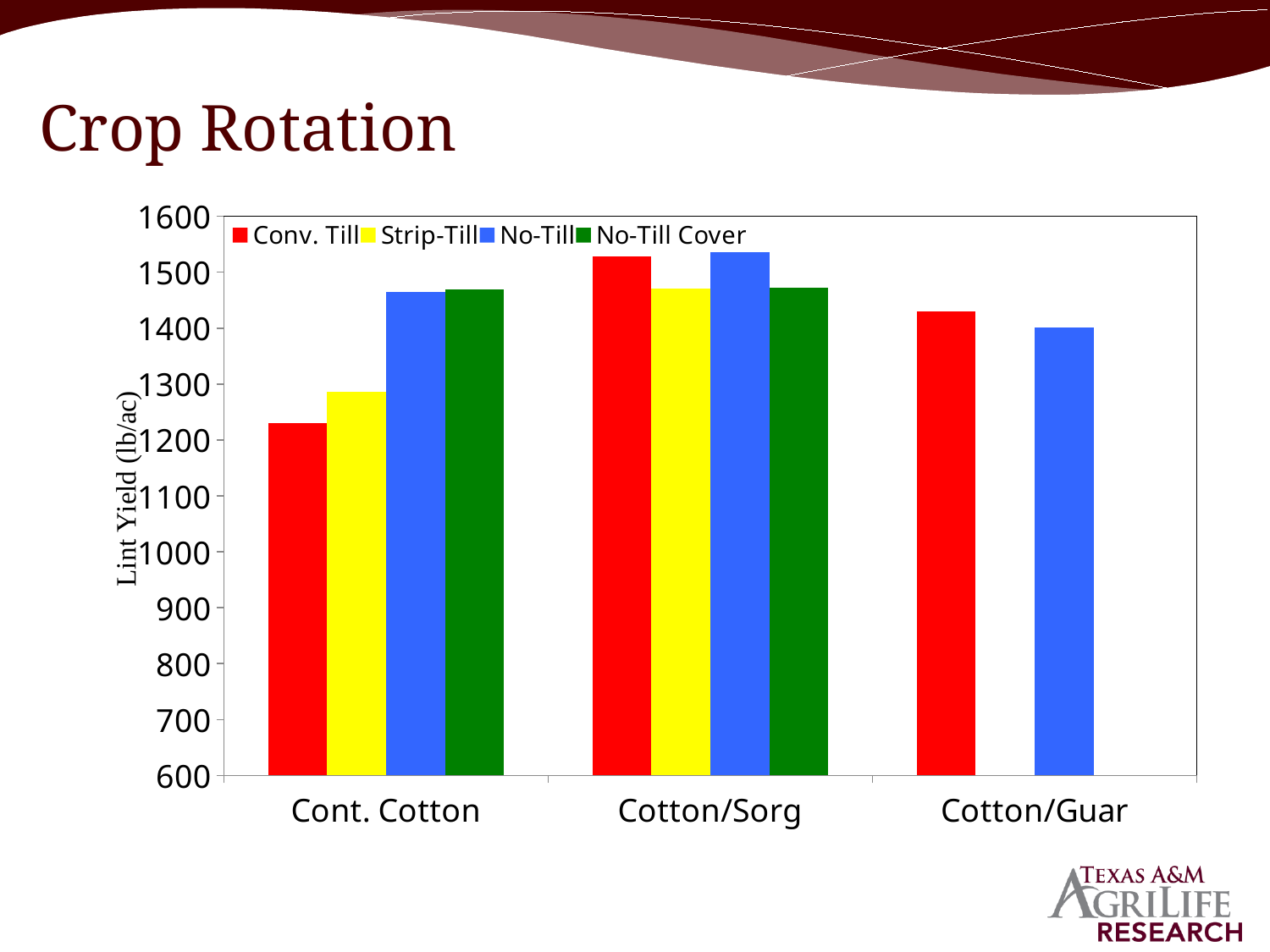
Which is larger for Cotton/Guar, the Conv. Till value or the No-Till value? Conv. Till Is the Strip-Till value for Cont. Cotton greater or less than 1200? greater Which category has the lowest Conv. Till lint yield? Cont. Cotton Which is larger for Cont. Cotton, the Conv. Till value or the Strip-Till value? Strip-Till Which colour represents the No-Till series in the legend? blue Is the Conv. Till value for Cont. Cotton greater or less than 1300? less How many crop rotation categories are shown on the x axis? 3 How many series does the legend list? 4 What kind of chart is shown on the slide? bar chart What is the label on the y axis? Lint Yield (lb/ac) Is the No-Till value for Cont. Cotton greater or less than 1400? greater